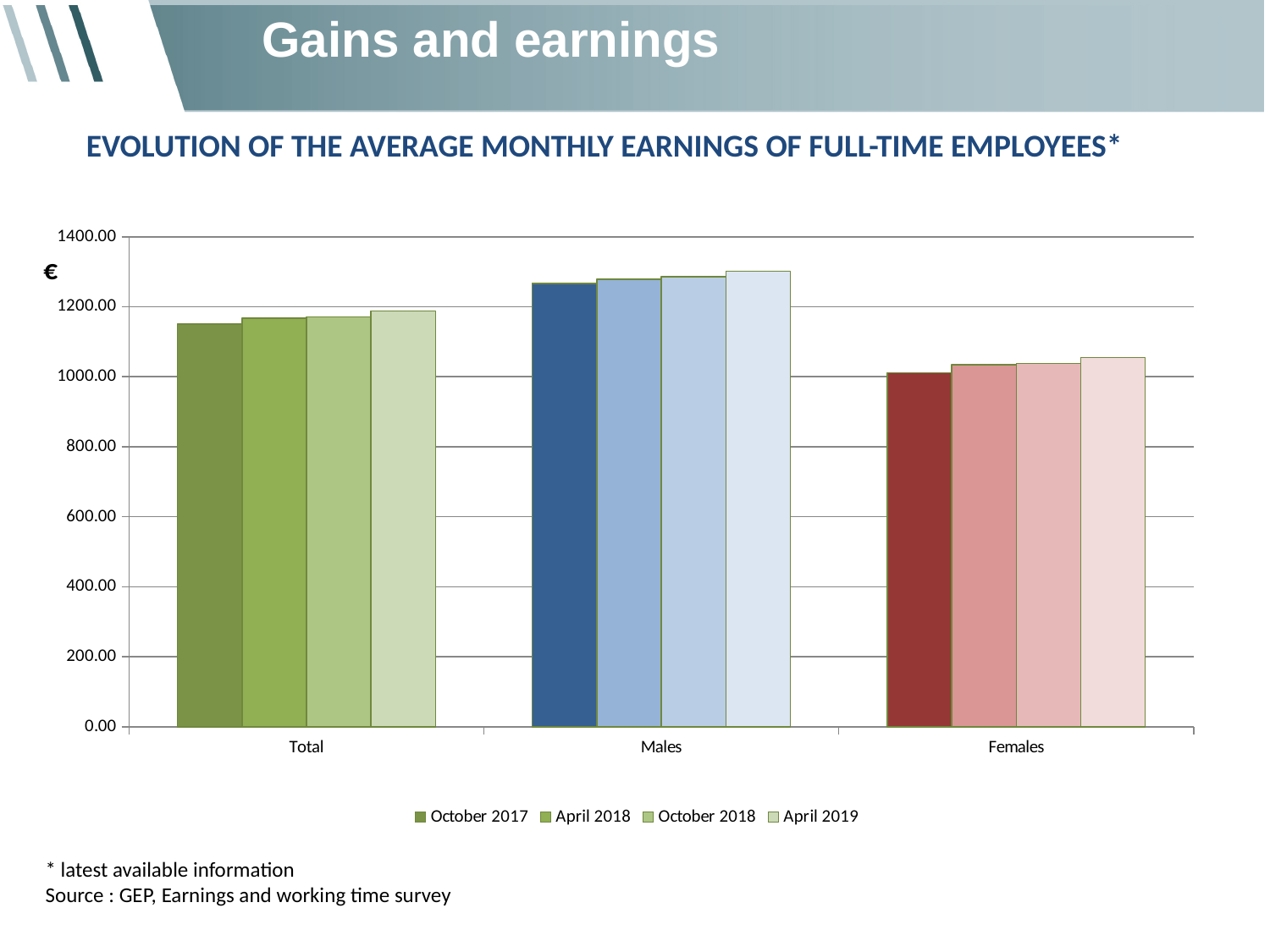
Which category has the highest average monthly earnings across all periods? Males What is the title of the chart? EVOLUTION OF THE AVERAGE MONTHLY EARNINGS OF FULL-TIME EMPLOYEES* Which category has the lowest average monthly earnings across all periods? Females Is the value for Females in April 2019 greater or less than 1000.00? greater Is the value for Males in April 2019 greater or less than 1200.00? greater Do the earnings for Females rise or fall from October 2017 to April 2019? rise Is the value for Total in October 2017 greater or less than 1200.00? less How many series does the legend list? 4 Which is larger, the April 2019 value for Males or the April 2019 value for Females? Males What kind of chart is shown on the slide? bar chart How many categories are shown on the x axis of the chart? 3